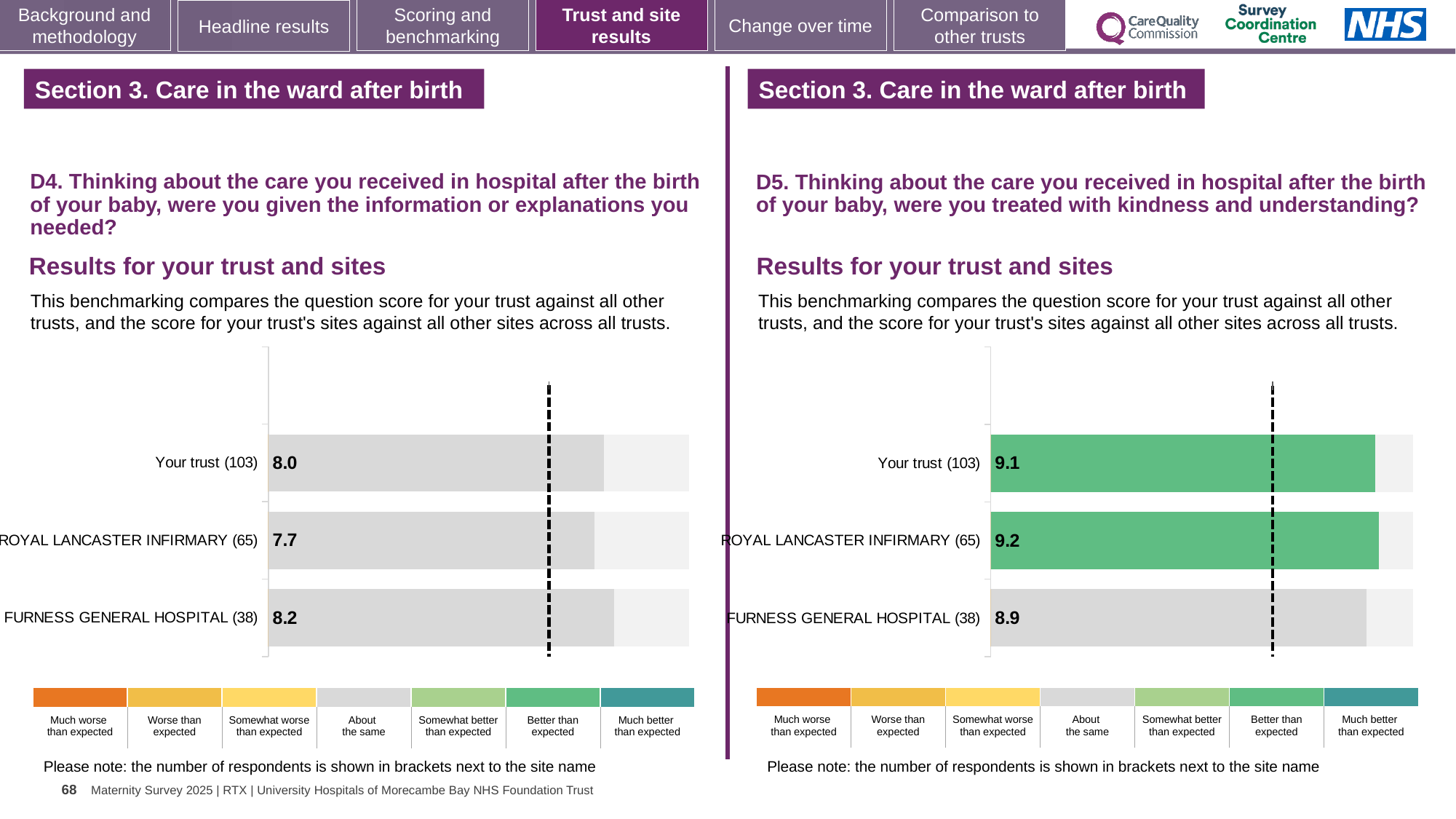
In the D5 chart on the right, what is the score for Your trust (103)? 9.1 How many bars are plotted in the D4 chart on the left? 3 What kind of chart is used for the D5 results on the right? Bar chart In the D4 chart on the left, which site or trust has the lowest score? ROYAL LANCASTER INFIRMARY (65) In the D5 chart on the right, which is larger: the score for Your trust (103) or the score for FURNESS GENERAL HOSPITAL (38)? Your trust (103) In the D4 chart on the left, what is the score for ROYAL LANCASTER INFIRMARY (65)? 7.7 In the D5 chart on the right, what is the difference between the scores for ROYAL LANCASTER INFIRMARY (65) and FURNESS GENERAL HOSPITAL (38)? 0.3 In the D4 chart on the left, what is the score for Your trust (103)? 8.0 In the D4 chart on the left, what is the difference between the scores for FURNESS GENERAL HOSPITAL (38) and ROYAL LANCASTER INFIRMARY (65)? 0.5 In the D5 chart on the right, which site or trust has the highest score? ROYAL LANCASTER INFIRMARY (65) In the D5 chart on the right, what is the score for FURNESS GENERAL HOSPITAL (38)? 8.9 In the D4 chart on the left, which site or trust has the highest score? FURNESS GENERAL HOSPITAL (38)